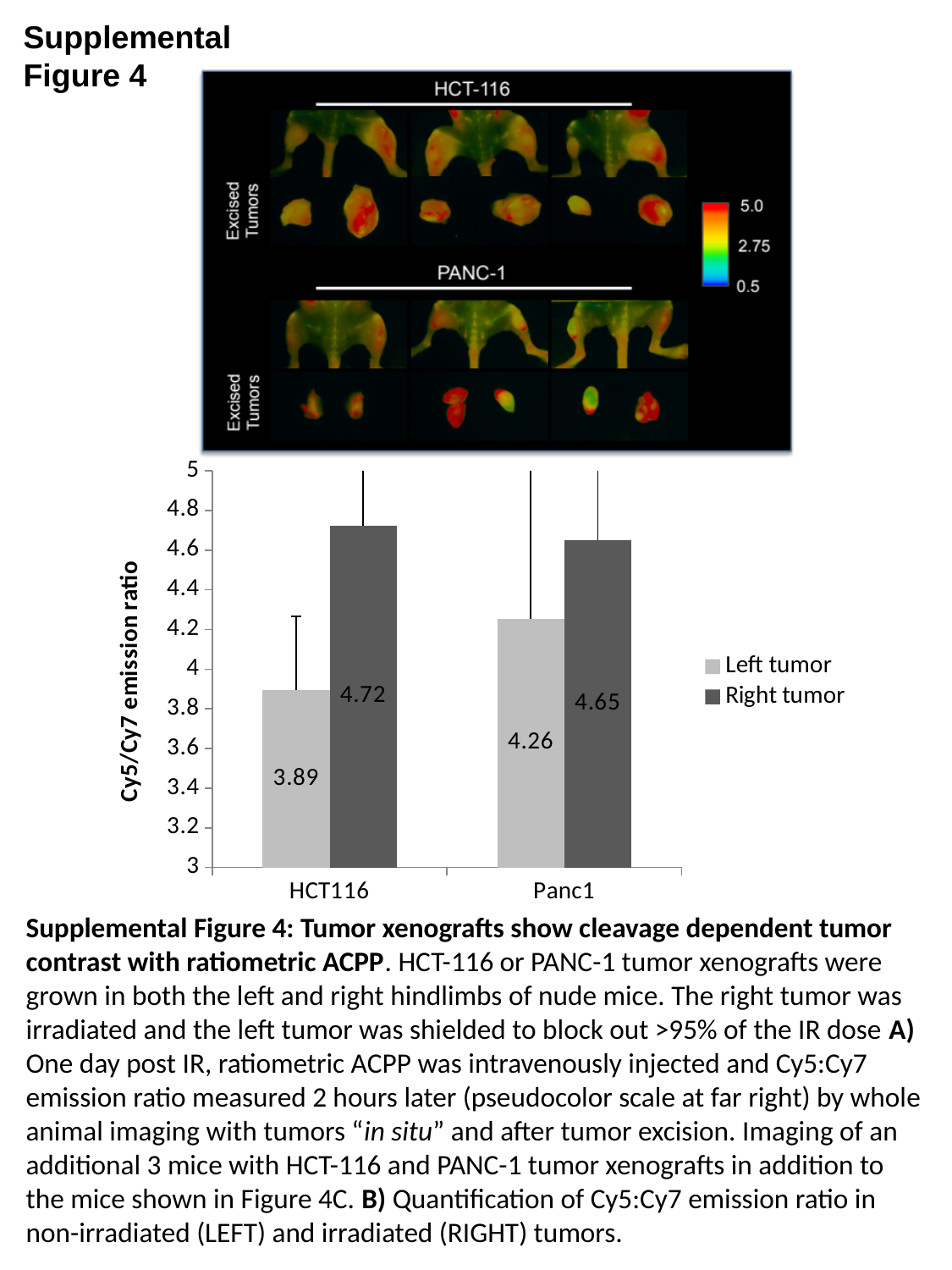
What is the Cy5/Cy7 emission ratio for the Left tumor in Panc1? 4.26 What is the difference between the Right tumor and Left tumor emission ratios for Panc1? 0.39 What is the Cy5/Cy7 emission ratio for the Left tumor in HCT116? 3.89 What type of chart is used to show the Cy5/Cy7 emission ratio? Bar chart Which bar has the lowest Cy5/Cy7 emission ratio in the chart? Left tumor, HCT116 What is the label of the y-axis of the bar chart? Cy5/Cy7 emission ratio Which is larger, the Left tumor value for HCT116 or the Left tumor value for Panc1? Panc1 How many series does the legend of the bar chart list? 2 What is the Cy5/Cy7 emission ratio for the Right tumor in Panc1? 4.65 What is the Cy5/Cy7 emission ratio for the Right tumor in HCT116? 4.72 Which bar has the highest Cy5/Cy7 emission ratio in the chart? Right tumor, HCT116 What is the difference between the Right tumor and Left tumor emission ratios for HCT116? 0.83